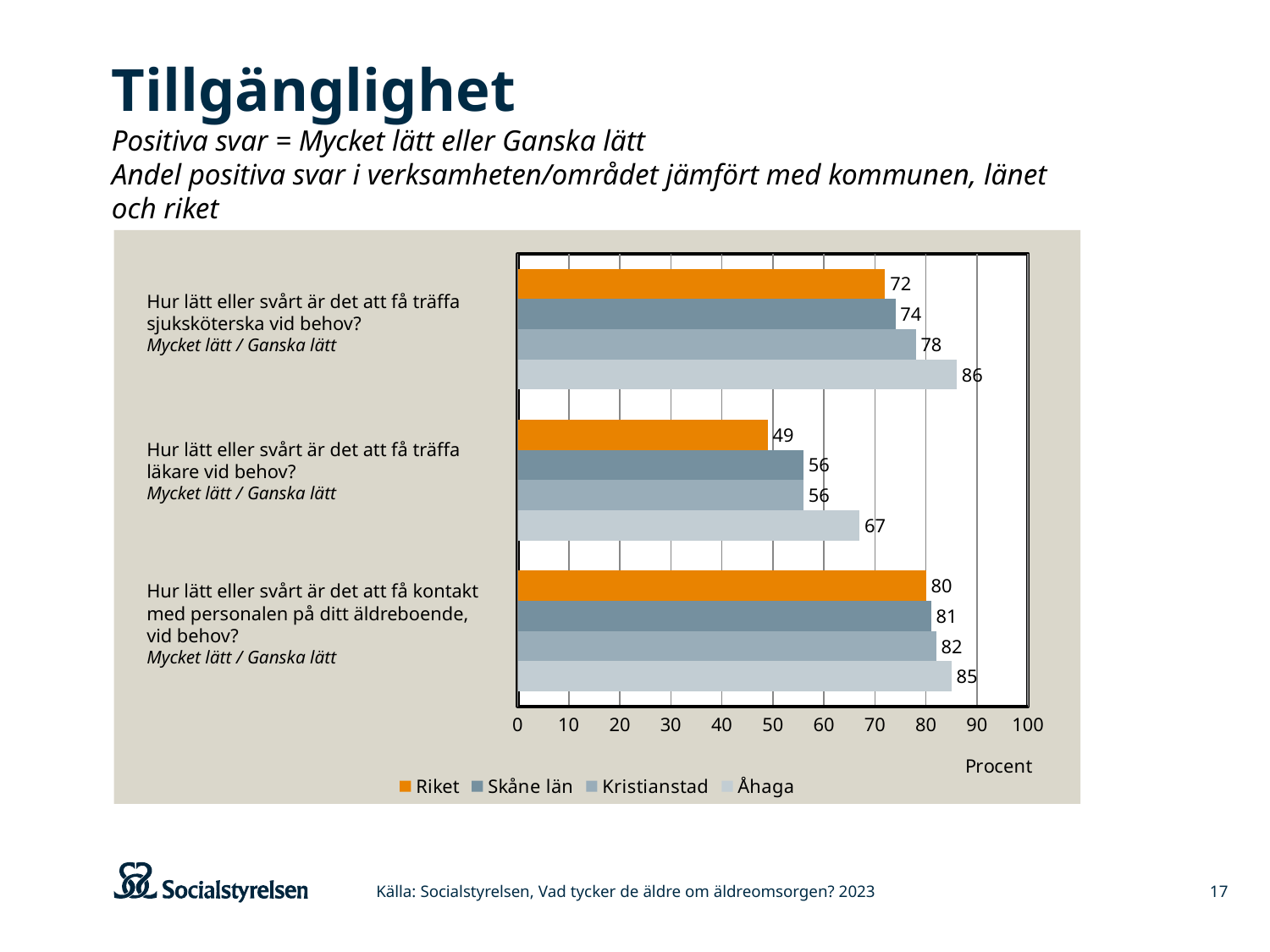
How many questions (categories) are shown on the chart? 3 What is the value for Riket on the question about meeting a doctor when needed (träffa läkare vid behov)? 49 Which series has the lowest value on the question about contacting staff at the care home? Riket What is the difference between Åhaga and Riket on the question about meeting a doctor when needed? 18 What kind of chart is shown on the slide? Bar chart What is the value for Skåne län on the question about meeting a nurse when needed? 74 Which series has the highest value on the question about meeting a doctor when needed? Åhaga What unit is shown on the horizontal axis of the chart? Procent What is the value for Åhaga on the question about meeting a nurse when needed (träffa sjuksköterska vid behov)? 86 What is the value for Kristianstad on the question about contacting staff at the care home (kontakt med personalen)? 82 Which is larger: Åhaga's value for meeting a nurse or Åhaga's value for contacting staff at the care home? Meeting a nurse (86) How many series does the legend list? 4